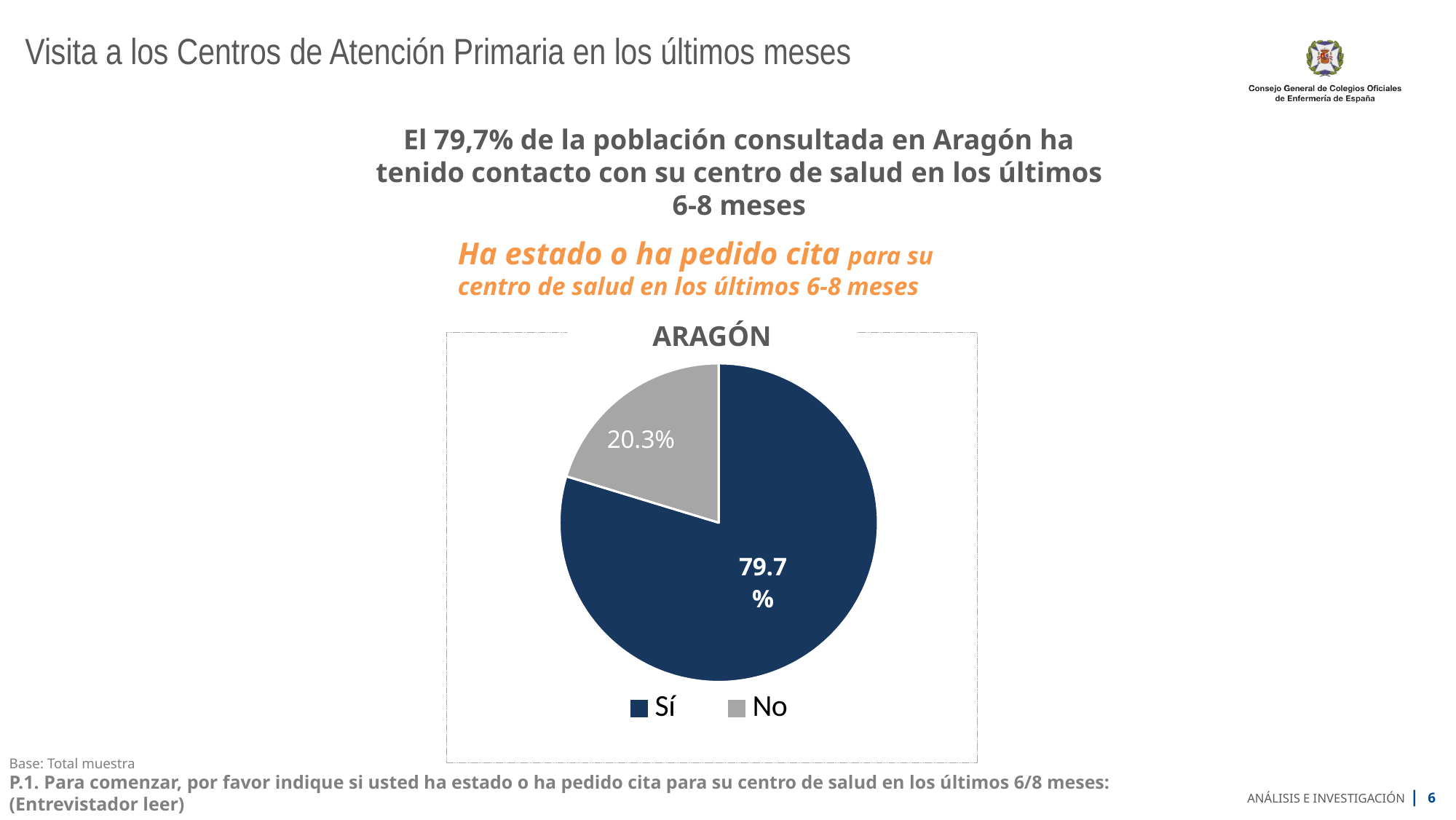
How many entries does the legend of the pie chart list? 2 Which is larger in the pie chart, "Sí" or "No"? Sí What colour is the "Sí" slice in the pie chart? Dark blue What type of chart is shown on the slide? Pie chart How many slices does the pie chart have? 2 Which slice of the pie chart is the smallest? No Which slice of the pie chart is the largest? Sí What share of the pie does the "No" slice represent? 20.3% What is the title of the pie chart? ARAGÓN What percentage of the pie chart is labelled "No"? 20.3% What percentage of the pie chart is labelled "Sí"? 79.7% What is the difference in percentage points between the "Sí" and "No" slices? 59.4